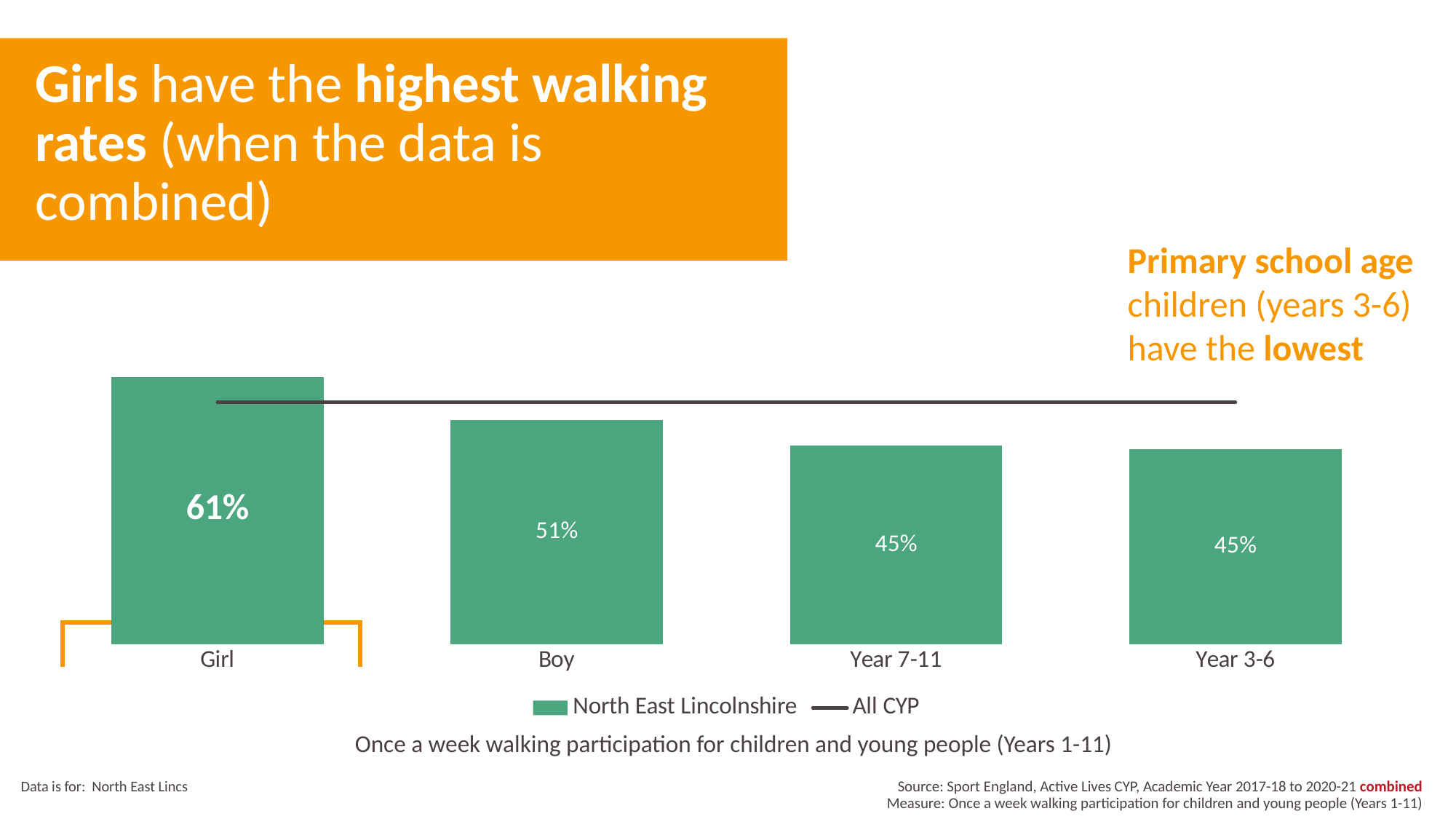
What is the once a week walking participation value for Boy? 51% What is the once a week walking participation value for Girl? 61% What kind of chart is used to show the walking participation data? Combination bar and line chart What are the two entries in the chart legend? North East Lincolnshire and All CYP What is the difference between the Boy and Year 7-11 values? 6 percentage points How many categories are shown on the x axis of the chart? 4 What is the value shown for Year 3-6? 45% Which is larger, the value for Boy or the value for Year 3-6? Boy Which category has the highest walking participation rate? Girl What is the value shown for Year 7-11? 45% What is the difference between the Girl and Boy values? 10 percentage points How many series does the chart legend list? 2